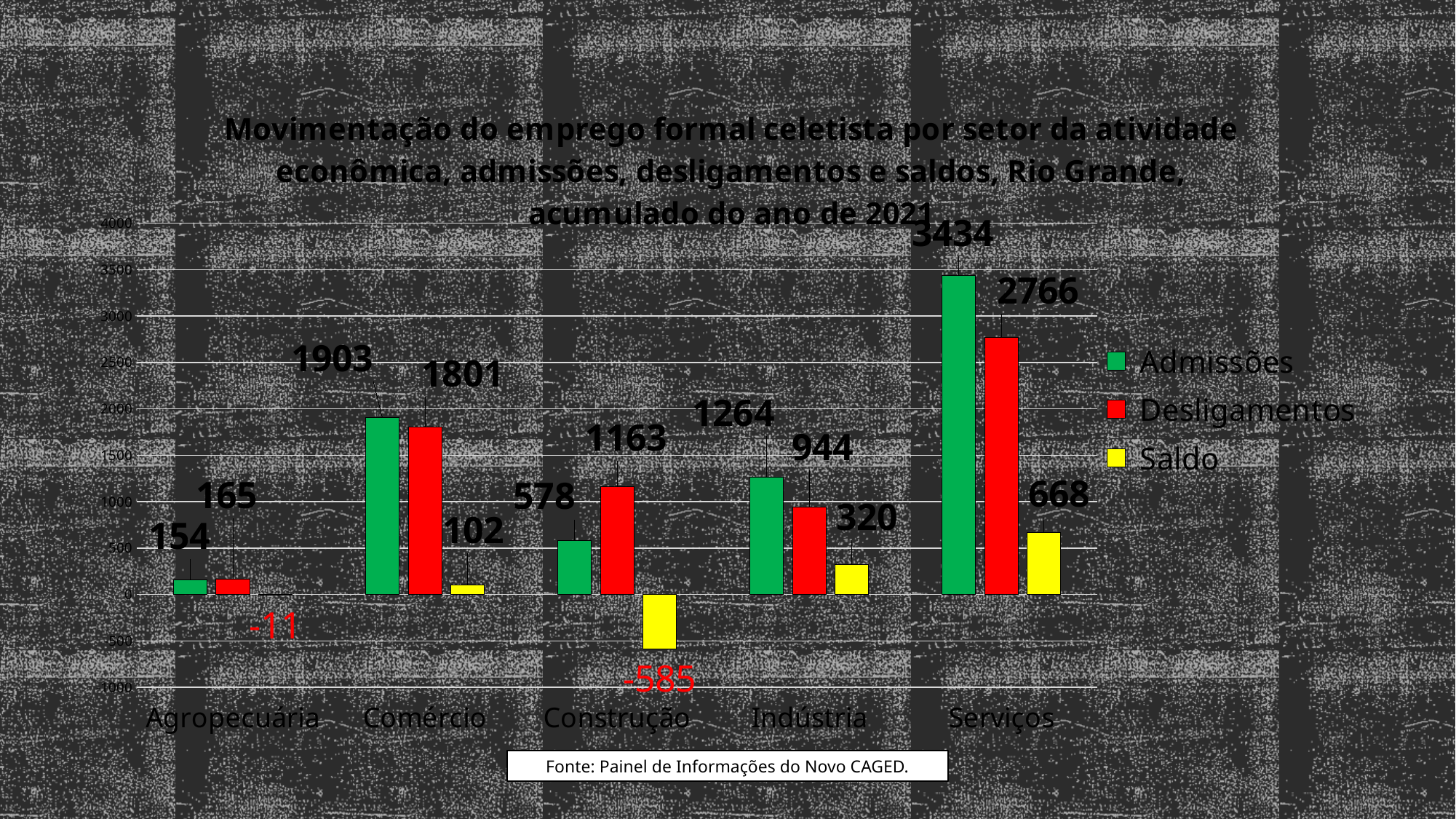
Which sector has the lowest Saldo value? Construção What is the difference between Admissões and Desligamentos for Comércio? 102 What is the Saldo value for Agropecuária? -11 What is the value of Desligamentos for Construção? 1163 What kind of chart is shown on the slide? Bar chart How many sectors are shown on the x axis? 5 Which colour represents the Saldo series in the legend? Yellow What is the value of Admissões for Serviços? 3434 How many series does the legend list? 3 Which sector has the highest Admissões value? Serviços Which is larger for Indústria, Admissões or Desligamentos? Admissões Is the Desligamentos value for Serviços greater or less than 2500? greater